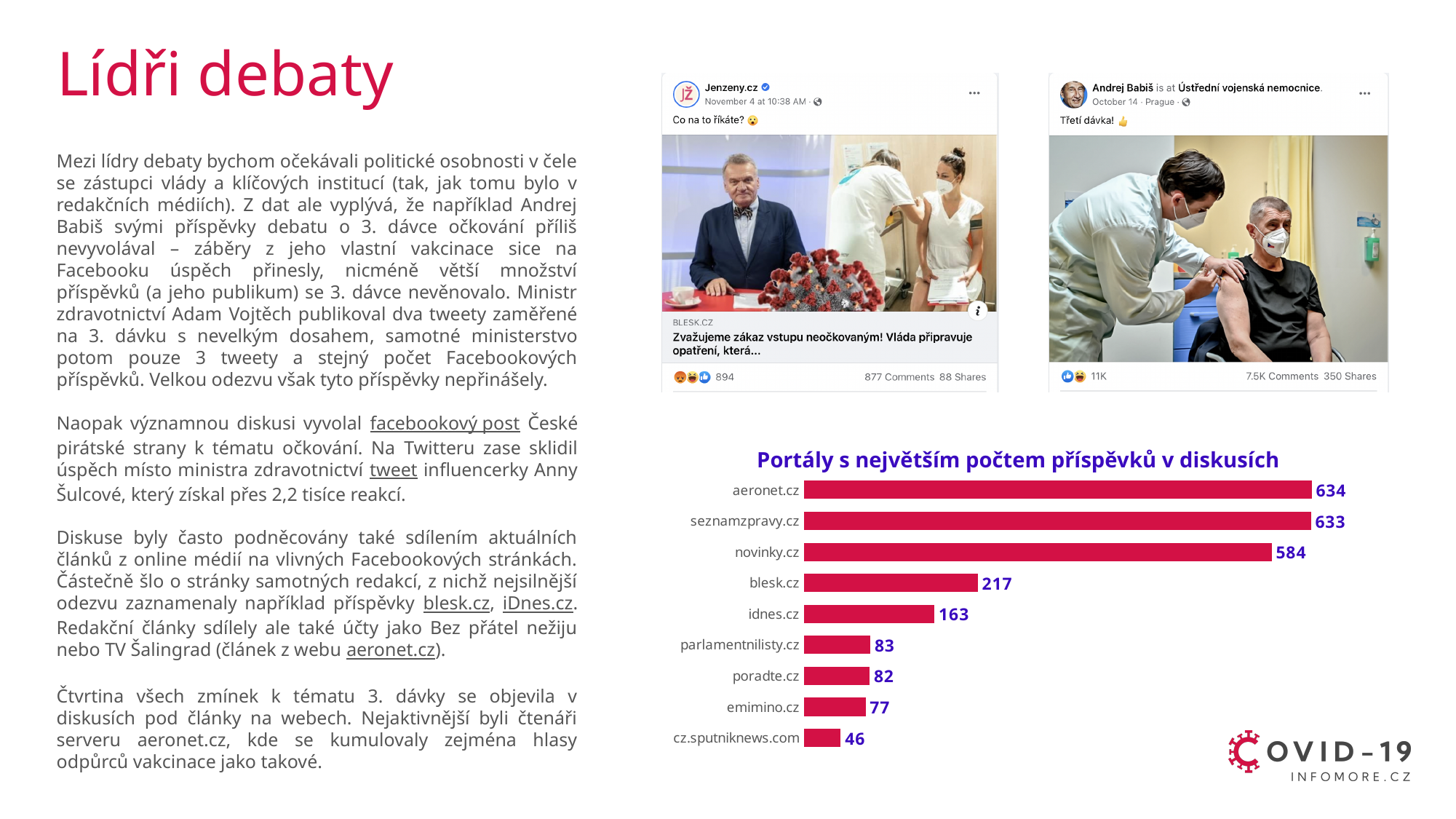
What is the difference between the values for aeronet.cz and cz.sputniknews.com? 588 Which portal has the highest value in the chart? aeronet.cz What is the title of the chart? Portály s největším počtem příspěvků v diskusích What is the value shown for cz.sputniknews.com? 46 How many portals are listed in the chart? 9 Which portal has the lowest value in the chart? cz.sputniknews.com Which has a larger value, poradte.cz or emimino.cz? poradte.cz How many posts does the chart show for blesk.cz? 217 What is the value for novinky.cz in the chart? 584 Which has a larger value, blesk.cz or idnes.cz? blesk.cz What is the difference between the values for novinky.cz and blesk.cz? 367 What kind of chart is shown on the slide? bar chart